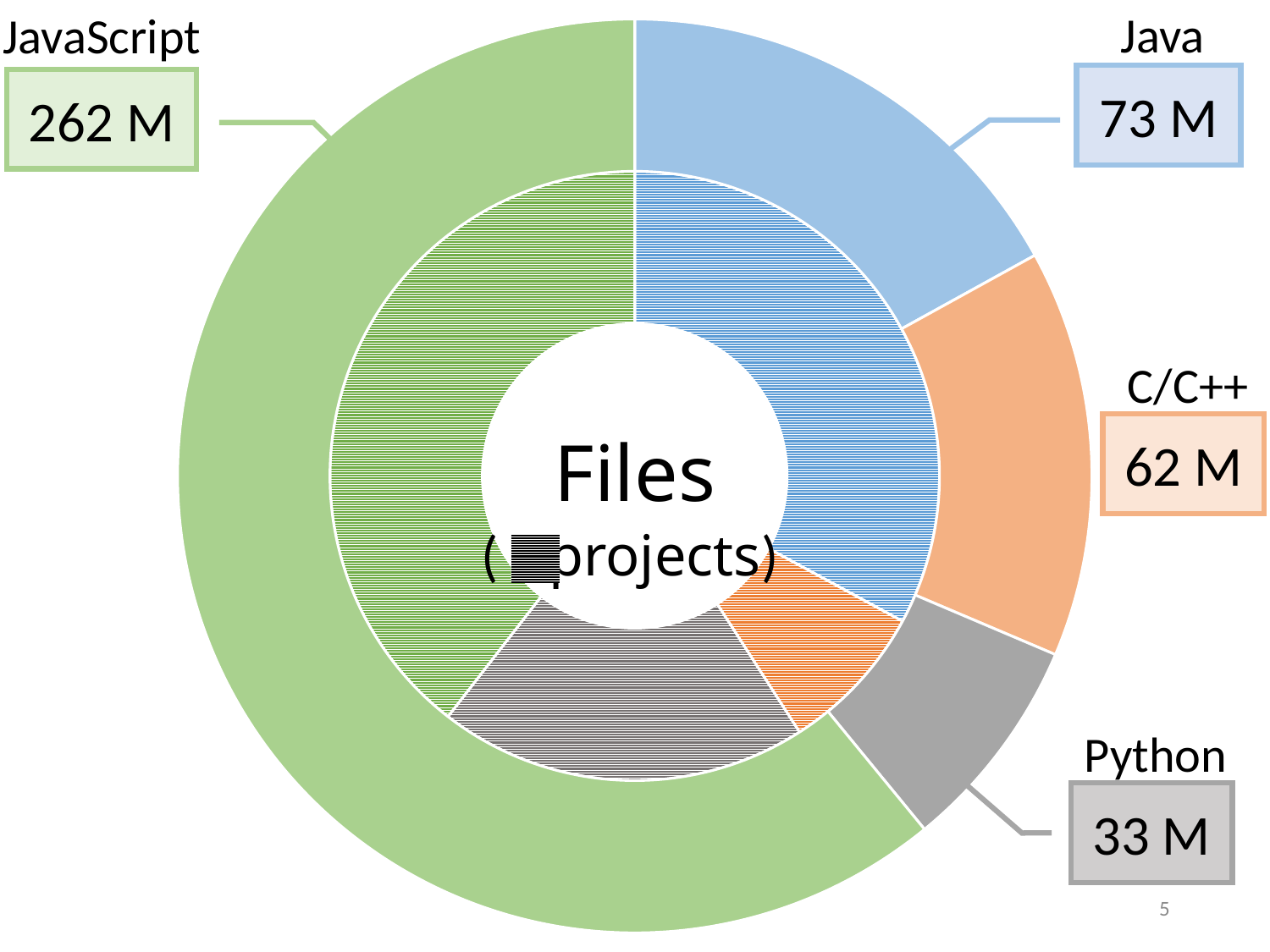
What is the difference between the JavaScript and Java values in the outer ring? 189 M Which is larger in the outer ring, Java or C/C++? Java What is the value shown for Python in the outer ring of the chart? 33 M Which language has the largest number of files in the outer ring? JavaScript Which language has the smallest number of files in the outer ring? Python What word is written in the centre of the chart above "projects"? Files What is the difference between the C/C++ and Python values in the outer ring? 29 M What is the value shown for JavaScript in the outer ring of the chart? 262 M What is the value shown for Java in the outer ring of the chart? 73 M How many languages are labelled on the chart? 4 What kind of chart is shown on the slide? Doughnut chart What is the value shown for C/C++ in the outer ring of the chart? 62 M